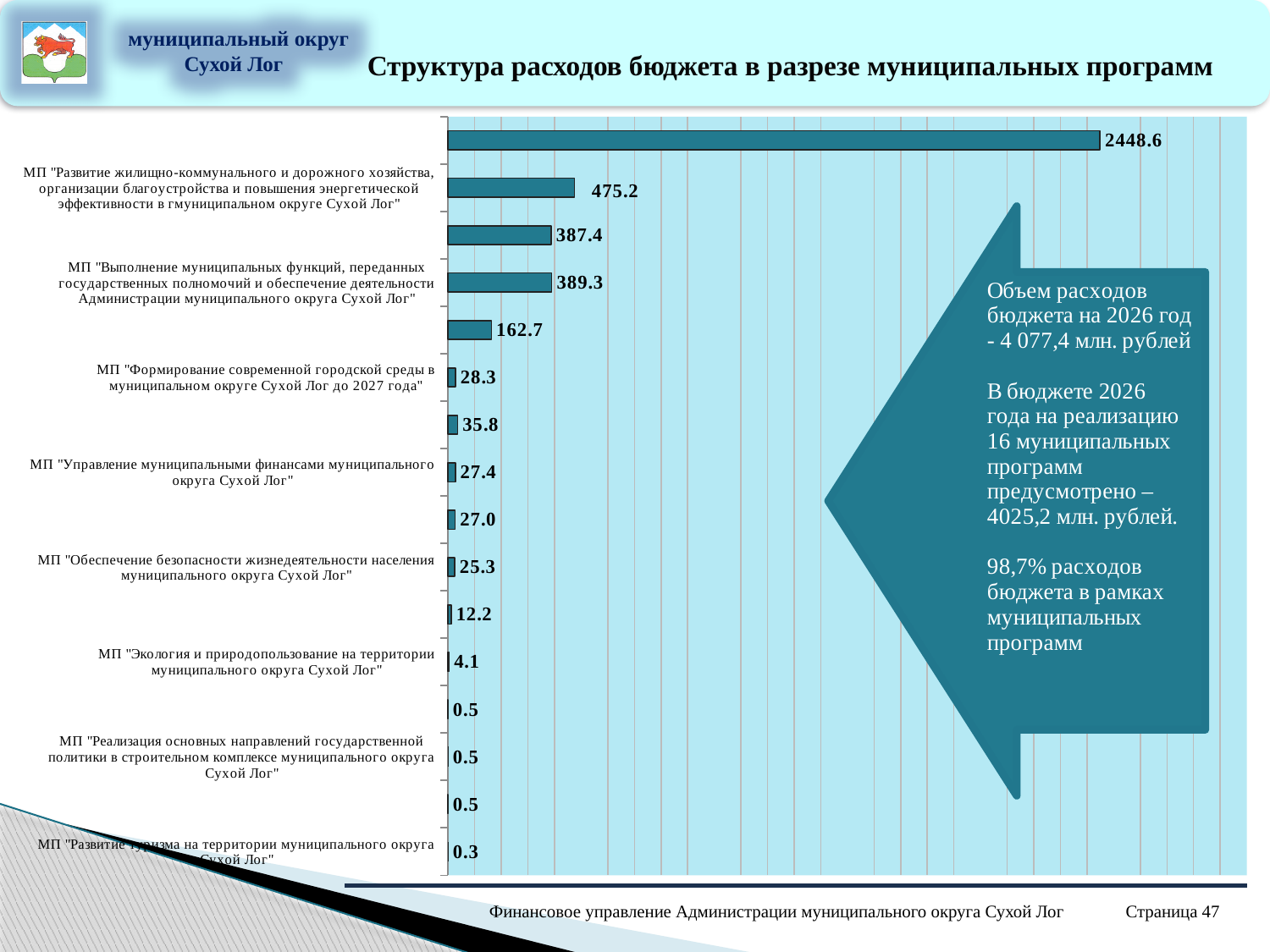
What is the difference between the value for МП "Развитие жилищно-коммунального и дорожного хозяйства..." and the value for МП "Выполнение муниципальных функций..."? 85.9 What is the title of the chart on the slide? Структура расходов бюджета в разрезе муниципальных программ What is the smallest value shown in the chart? 0.3 Which has the larger value: МП "Формирование современной городской среды..." or МП "Управление муниципальными финансами..."? МП "Формирование современной городской среды в муниципальном округе Сухой Лог до 2027 года" What kind of chart is shown on the slide? bar chart What is the largest value shown in the chart? 2448.6 What is the value for МП "Развитие жилищно-коммунального и дорожного хозяйства, организации благоустройства и повышения энергетической эффективности в муниципальном округе Сухой Лог"? 475.2 What is the value for МП "Экология и природопользование на территории муниципального округа Сухой Лог"? 4.1 What is the value for МП "Обеспечение безопасности жизнедеятельности населения муниципального округа Сухой Лог"? 25.3 What is the value for МП "Выполнение муниципальных функций, переданных государственных полномочий и обеспечение деятельности Администрации муниципального округа Сухой Лог"? 389.3 How many bars are plotted in the chart? 16 What is the value for МП "Формирование современной городской среды в муниципальном округе Сухой Лог до 2027 года"? 28.3